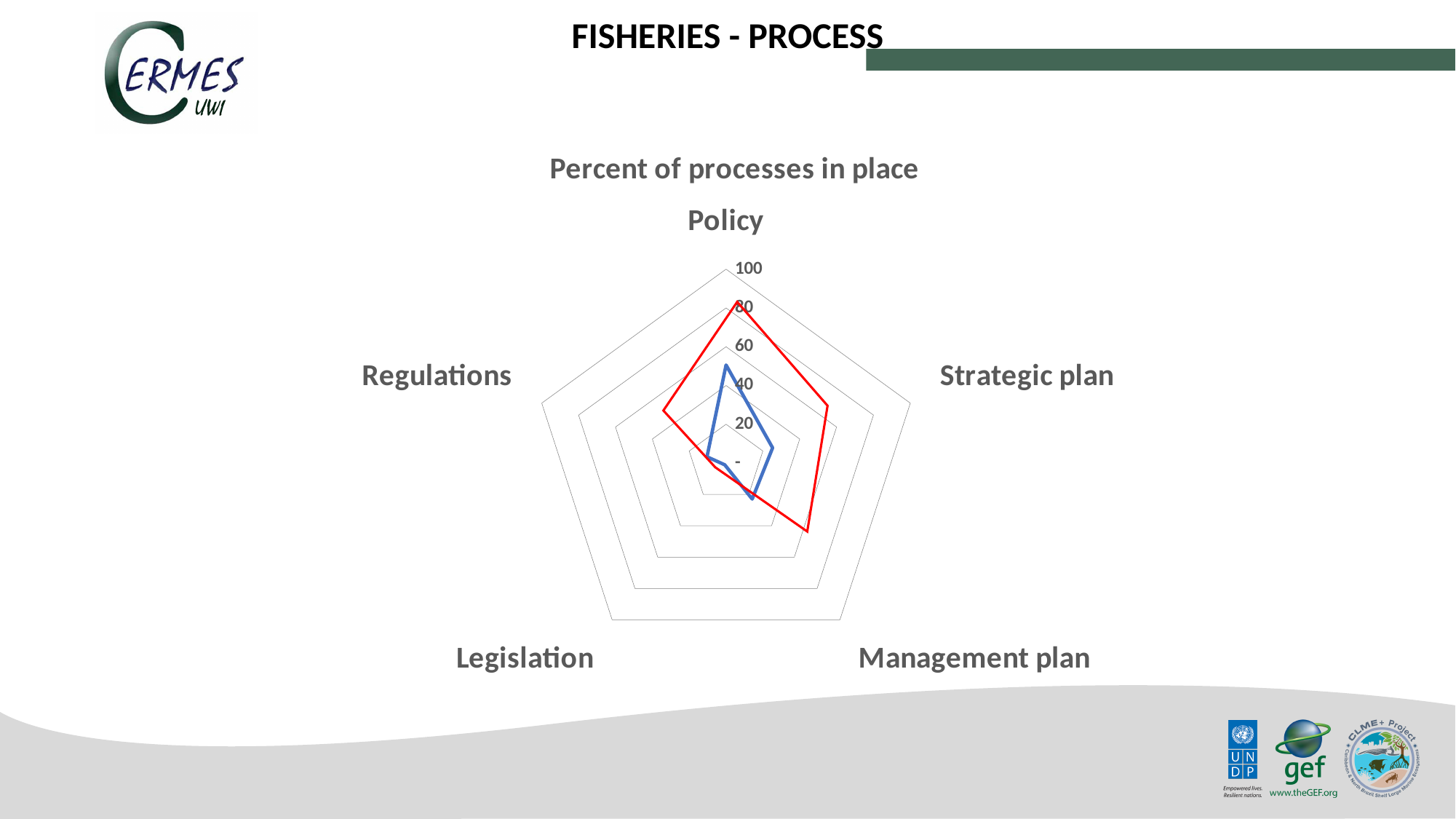
On which category does the red series have its lowest value? Legislation What kind of chart is shown on the slide? Radar chart What is the maximum value shown on the chart's axis scale? 100 How many data series (lines) are plotted on the radar chart? 2 How many categories (axes) does the radar chart have? 5 Is the blue series value for Policy greater or less than 40? greater Is the blue series value for Regulations greater or less than 40? less Is the red series value for Management plan greater or less than 40? greater For Strategic plan, which series has the larger value, the red or the blue? Red What is the title of the chart? Percent of processes in place